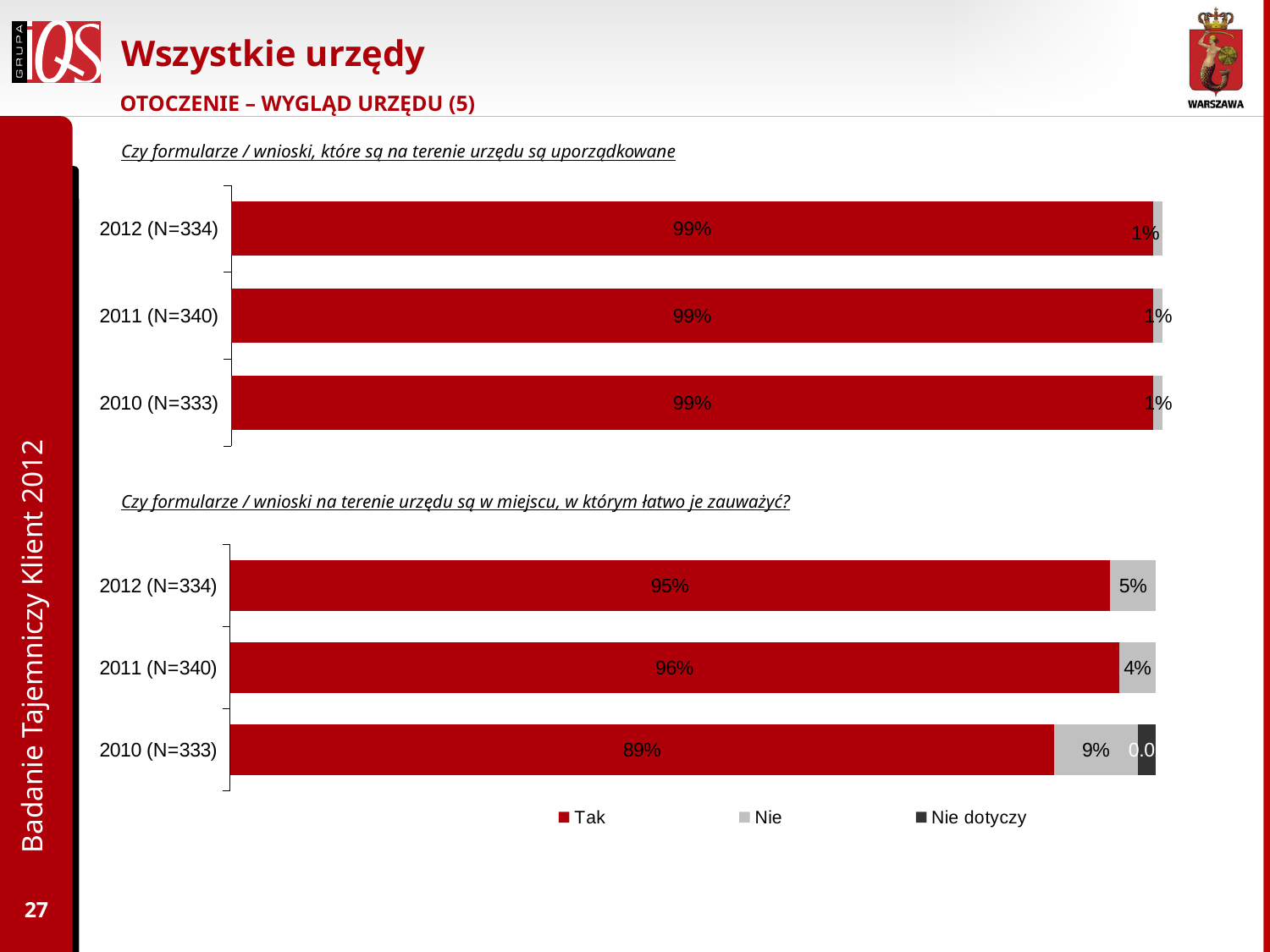
In the bottom chart ("Czy formularze / wnioski na terenie urzędu są w miejscu, w którym łatwo je zauważyć?"), which year has the highest "Nie" value? 2010 (N=333) In the bottom chart ("Czy formularze / wnioski na terenie urzędu są w miejscu, w którym łatwo je zauważyć?"), which is larger: the "Nie" value for 2012 (N=334) or for 2011 (N=340)? 2012 (N=334) In the bottom chart ("Czy formularze / wnioski na terenie urzędu są w miejscu, w którym łatwo je zauważyć?"), what is the difference between the "Tak" values for 2011 (N=340) and 2010 (N=333)? 7% In the bottom chart ("Czy formularze / wnioski na terenie urzędu są w miejscu, w którym łatwo je zauważyć?"), which year has the lowest "Tak" value? 2010 (N=333) In the bottom chart ("Czy formularze / wnioski na terenie urzędu są w miejscu, w którym łatwo je zauważyć?"), what is the "Tak" value for 2010 (N=333)? 89% How many series does the legend at the bottom of the slide list? 3 How many year categories are shown in the top chart ("Czy formularze / wnioski, które są na terenie urzędu są uporządkowane")? 3 In the bottom chart ("Czy formularze / wnioski na terenie urzędu są w miejscu, w którym łatwo je zauważyć?"), what is the "Nie" value for 2012 (N=334)? 5% In the bottom chart ("Czy formularze / wnioski na terenie urzędu są w miejscu, w którym łatwo je zauważyć?"), what is the "Tak" value for 2011 (N=340)? 96% In the top chart ("Czy formularze / wnioski, które są na terenie urzędu są uporządkowane"), what is the "Nie" value for 2010 (N=333)? 1% In the top chart ("Czy formularze / wnioski, które są na terenie urzędu są uporządkowane"), what is the "Tak" value for 2012 (N=334)? 99% What type of chart is the bottom chart ("Czy formularze / wnioski na terenie urzędu są w miejscu, w którym łatwo je zauważyć?")? Stacked bar chart